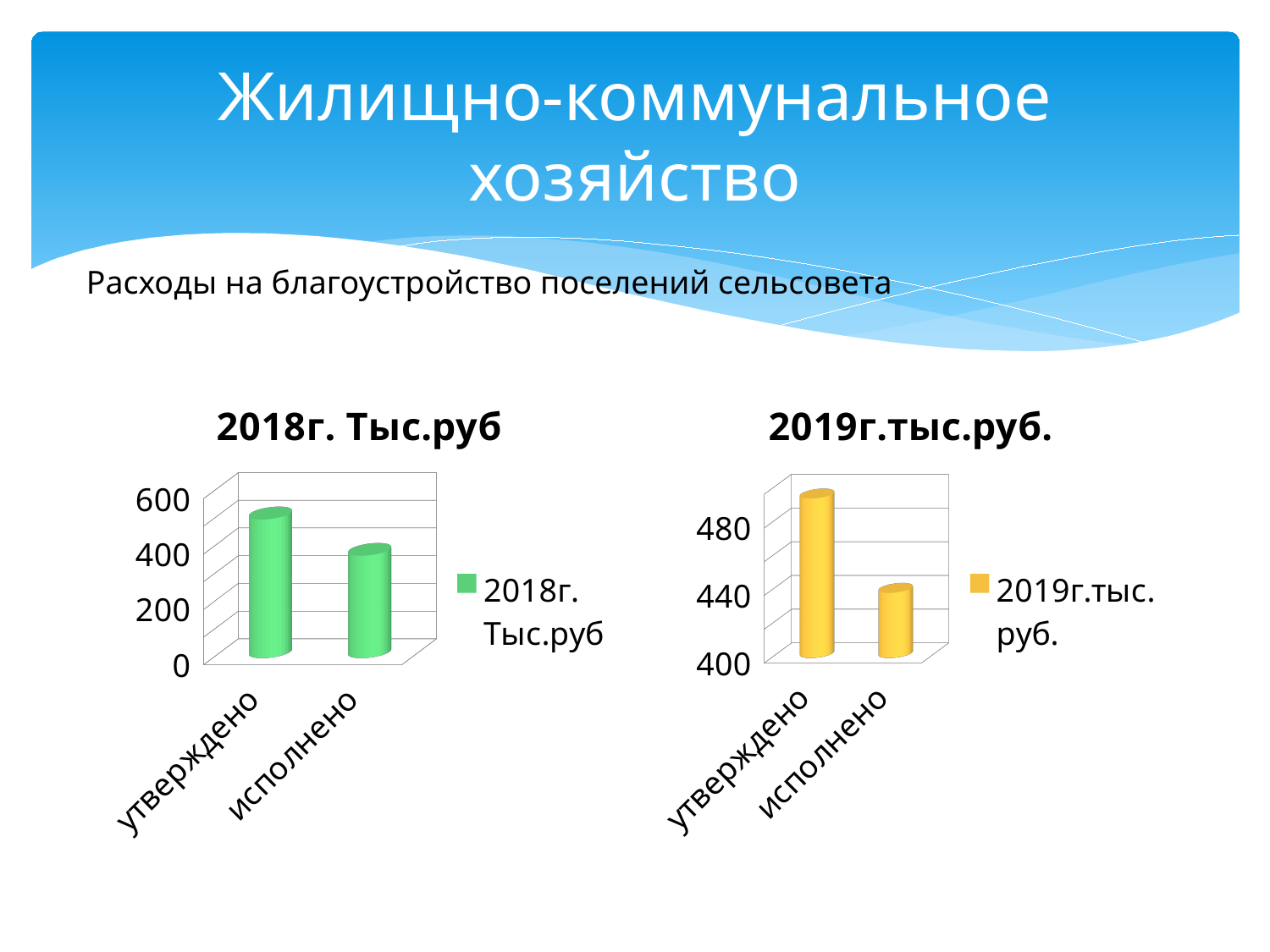
In the "2018г. Тыс.руб" chart, is the value for исполнено greater or less than 200? greater In the "2019г.тыс.руб." chart, which is larger, утверждено or исполнено? утверждено How many categories are shown in the "2018г. Тыс.руб" chart? 2 In the "2019г.тыс.руб." chart, which category has the highest value? утверждено What kind of chart is the "2018г. Тыс.руб" chart? bar chart In the "2019г.тыс.руб." chart, is the value for исполнено greater or less than 480? less In the "2019г.тыс.руб." chart, is the value for утверждено greater or less than 480? greater How many series does the legend of the "2019г.тыс.руб." chart list? 1 In the "2018г. Тыс.руб" chart, which category has the lowest value? исполнено In the "2018г. Тыс.руб" chart, which category has the highest value? утверждено What kind of chart is the "2019г.тыс.руб." chart? bar chart